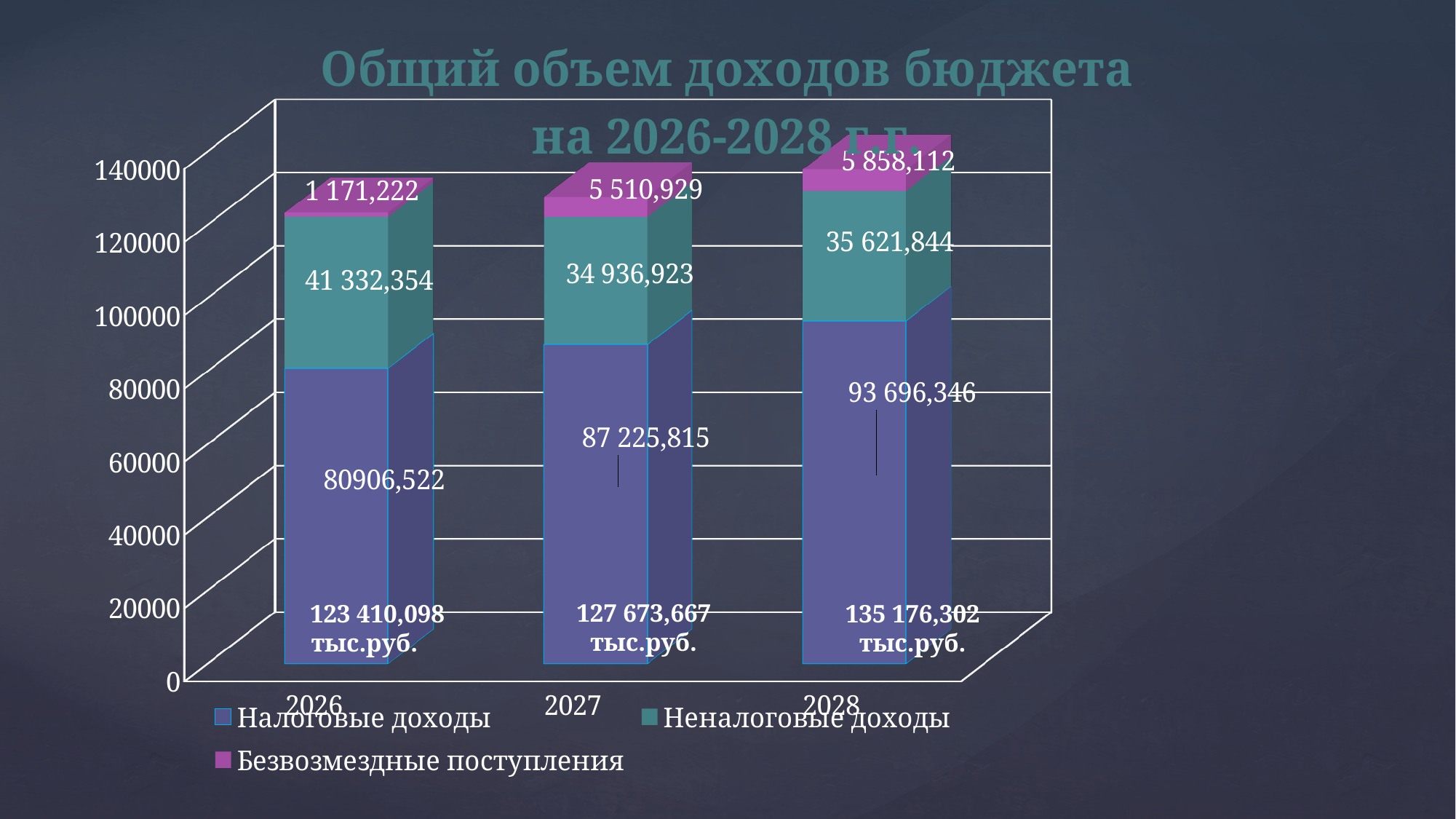
What is the total budget income for 2027 as printed on the slide? 127 673,667 тыс.руб. How many years are shown on the x axis? 3 Do Налоговые доходы rise or fall from 2026 to 2028? Rise In which year are Налоговые доходы the highest? 2028 How many series does the legend list? 3 What kind of chart is shown on the slide? Stacked bar chart What is the value of Безвозмездные поступления for 2028? 5 858,112 Which year has the larger value of Неналоговые доходы, 2026 or 2028? 2026 What is the value of Неналоговые доходы for 2027? 34 936,923 By how much do Налоговые доходы in 2028 exceed those in 2027? 6 470,531 In which year are Безвозмездные поступления the lowest? 2026 What is the value of Налоговые доходы for 2026? 80906,522